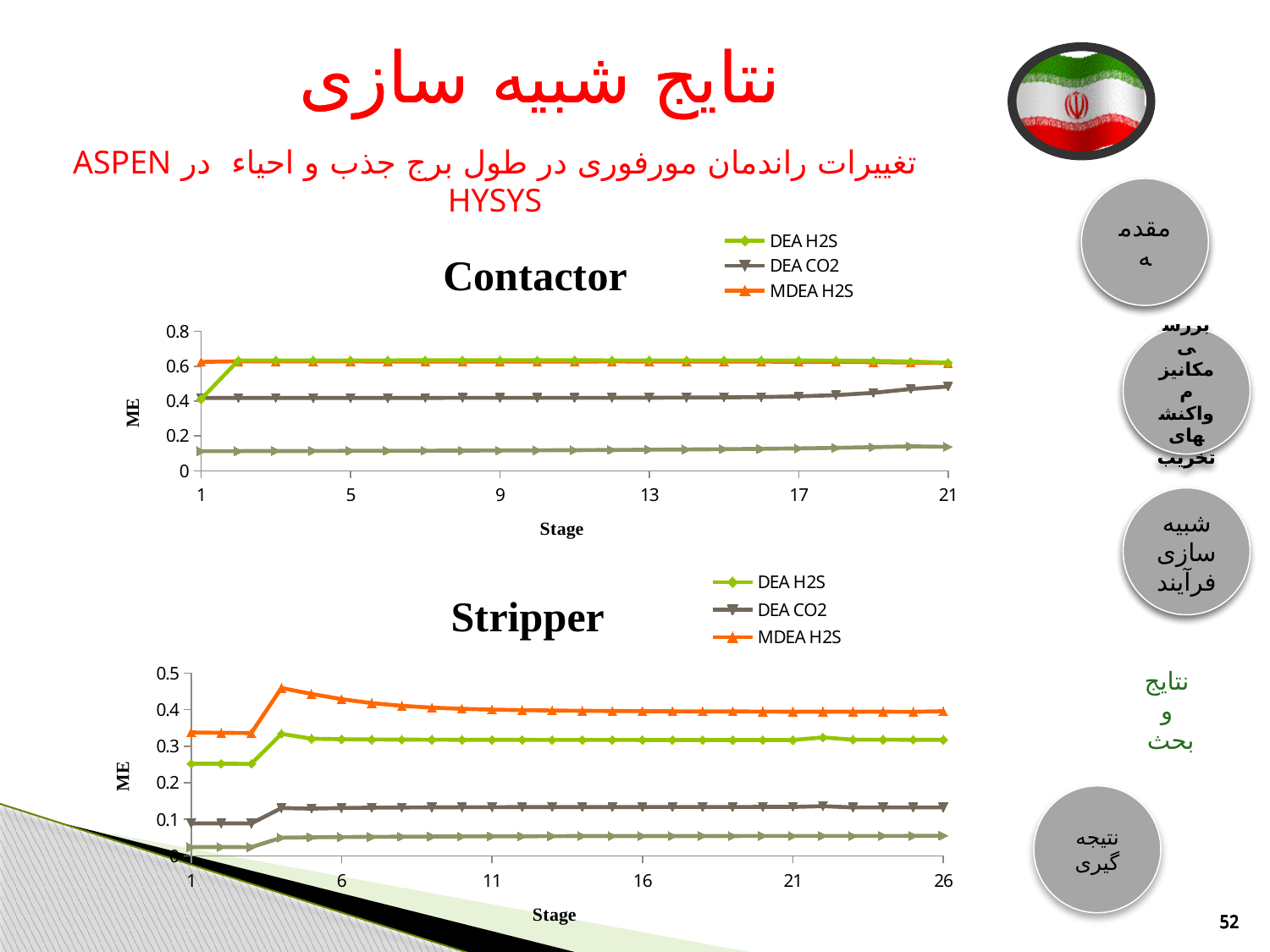
In the Contactor chart, does the DEA CO2 line rise or fall between stage 17 and stage 21? rise What kind of chart is the Contactor chart? line chart In the Stripper chart, is the value for DEA CO2 at stage 1 greater or less than 0.2? less What is the x-axis label of the Stripper chart? Stage In the Contactor chart, is the value for DEA CO2 at stage 1 greater or less than 0.6? less In the Stripper chart, which series is higher at stage 16, MDEA H2S or DEA H2S? MDEA H2S In the Stripper chart, is the value for DEA H2S at stage 1 greater or less than 0.2? greater In the Contactor chart, which series is higher at stage 9, MDEA H2S or DEA CO2? MDEA H2S In the Stripper chart, does the MDEA H2S line rise or fall between stage 4 and stage 26? fall How many series does the legend of the Stripper chart list? 3